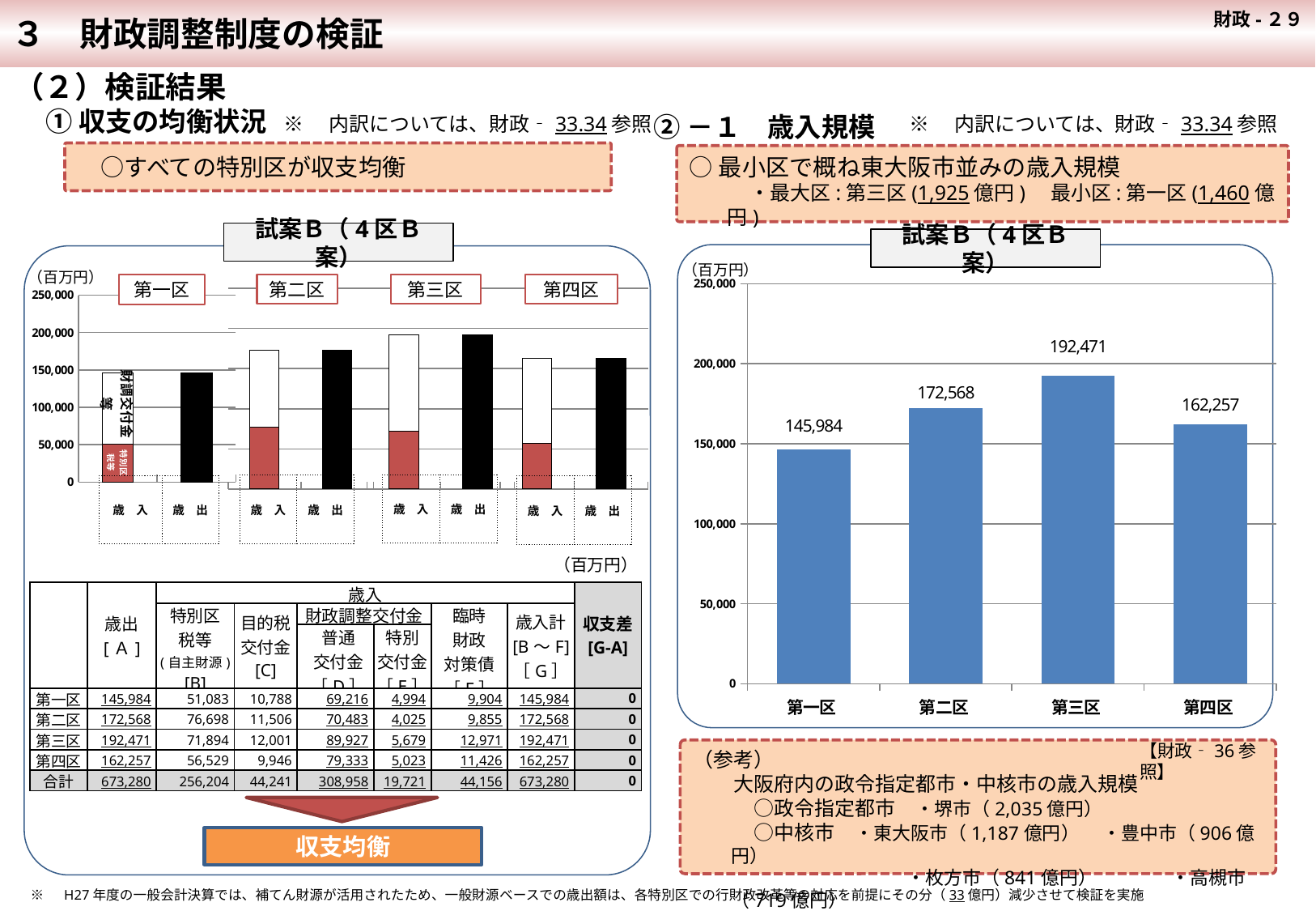
In the right-hand bar chart (歳入規模), what is the difference between the values for 第二区 and 第四区? 10,311 In the right-hand bar chart (歳入規模), what is the difference between the values for 第三区 and 第一区? 46,487 In the right-hand bar chart (歳入規模), which district has the lowest value? 第一区 What kind of chart is the right-hand chart (歳入規模)? Bar chart What kind of chart is the left-hand chart showing 歳入 and 歳出 for each district? Stacked bar chart In the right-hand bar chart (歳入規模), what is the value for 第一区? 145,984 In the right-hand bar chart (歳入規模), which is larger, the value for 第二区 or the value for 第四区? 第二区 What unit is shown on the axis of the right-hand bar chart (歳入規模)? 百万円 In the left-hand chart (収支の均衡状況), is the 歳出 bar for 第三区 greater or less than 150,000? greater In the right-hand bar chart (試案B（4区B案）, 歳入規模), what is the value for 第三区? 192,471 How many districts are plotted in the right-hand bar chart (歳入規模)? 4 In the right-hand bar chart (歳入規模), which district has the highest value? 第三区